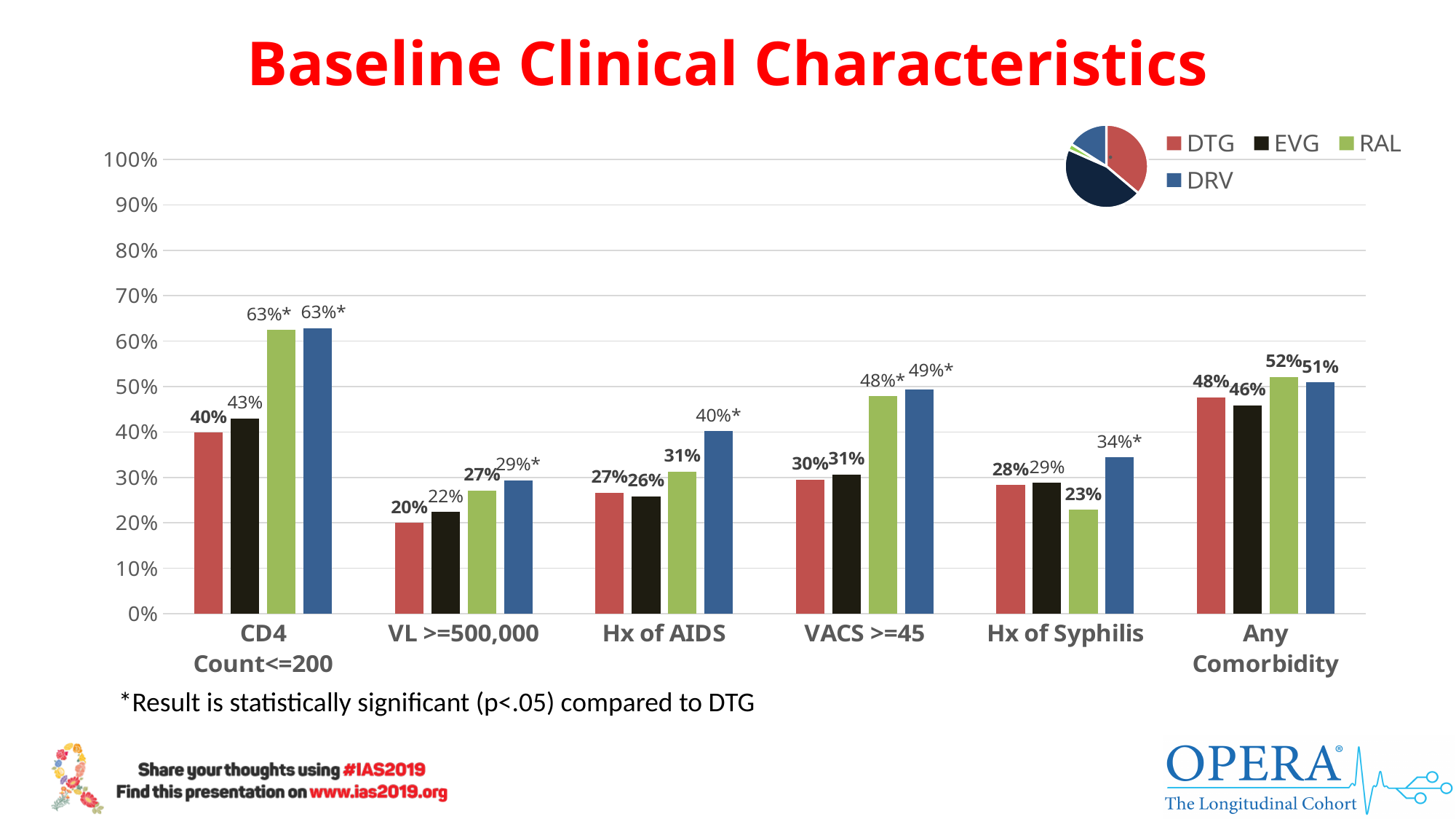
In the bar chart, which series has the lowest value in the VL >=500,000 category? DTG What type of chart is the large chart on the slide? Bar chart In the bar chart, what is the difference between the RAL and DTG values in the VACS >=45 category? 18% In the bar chart, what is the value for DRV in the Hx of AIDS category? 40% In the bar chart, is the value for DRV in the CD4 Count<=200 category greater or less than 50%? greater In the bar chart, which series has the highest value in the Hx of Syphilis category? DRV In the bar chart, what is the value for DTG in the CD4 Count<=200 category? 40% In the bar chart, what is the value for EVG in the Any Comorbidity category? 46% How many categories are shown on the x axis of the bar chart? 6 In the bar chart, what is the value for RAL in the Hx of Syphilis category? 23% In the bar chart, which is larger in the Hx of AIDS category: the DTG value or the RAL value? RAL How many series does the legend of the bar chart list? 4